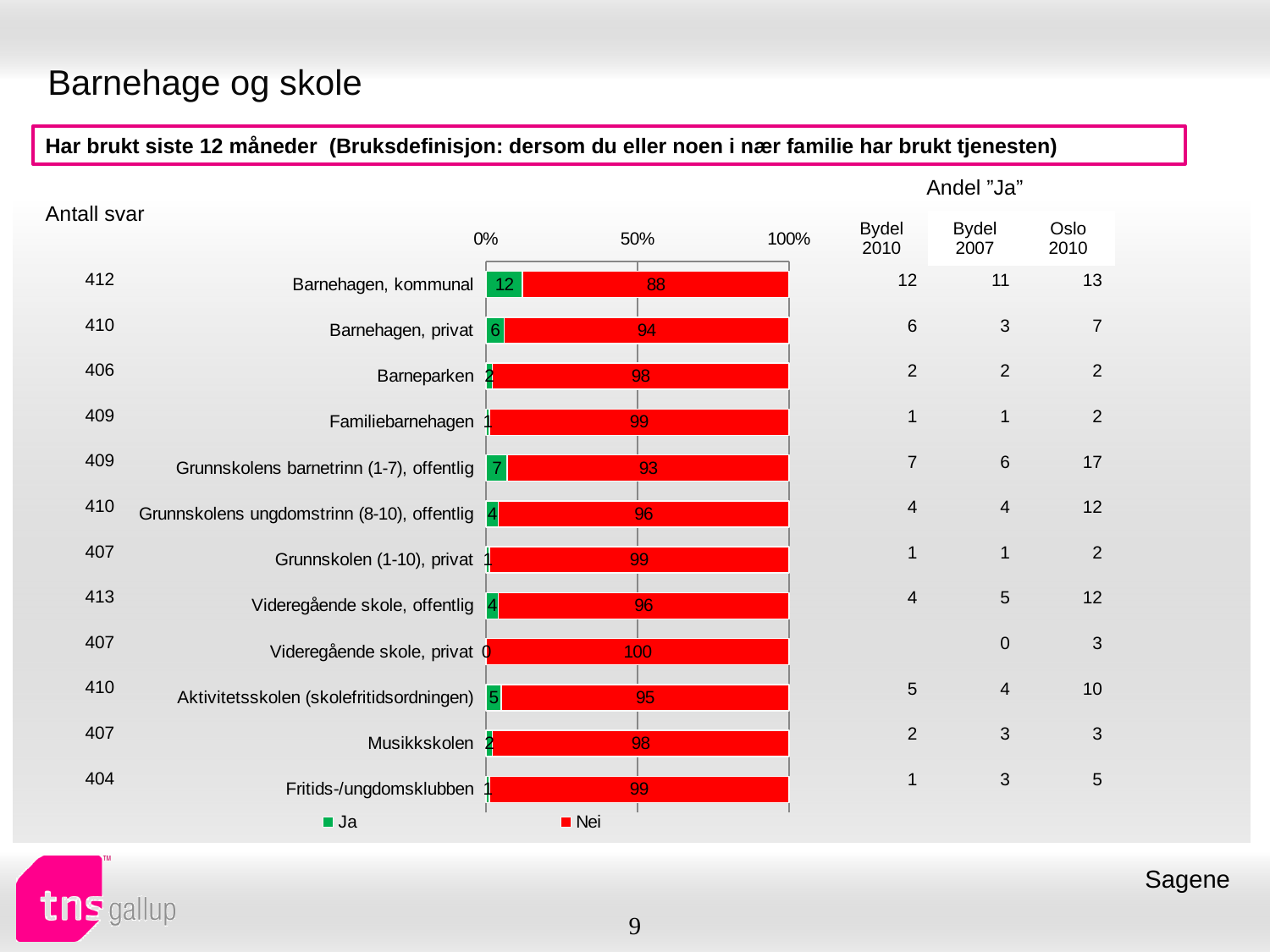
What is the difference between the 'Ja' values for Barnehagen, kommunal and Barnehagen, privat? 6 Which has a larger 'Ja' value: Grunnskolens barnetrinn (1-7), offentlig or Musikkskolen? Grunnskolens barnetrinn (1-7), offentlig What is the total of the stacked bar for Videregående skole, offentlig? 100 What is the 'Nei' value for Aktivitetsskolen (skolefritidsordningen)? 95 What kind of chart is shown on the slide? Stacked bar chart How many categories are shown in the chart? 12 Which category has the highest 'Ja' value? Barnehagen, kommunal What is the 'Nei' value for Barnehagen, kommunal? 88 What is the 'Ja' value for Grunnskolens barnetrinn (1-7), offentlig? 7 Which category has the lowest 'Ja' value? Videregående skole, privat How many series does the legend list? 2 Which colour represents 'Nei' in the chart? Red